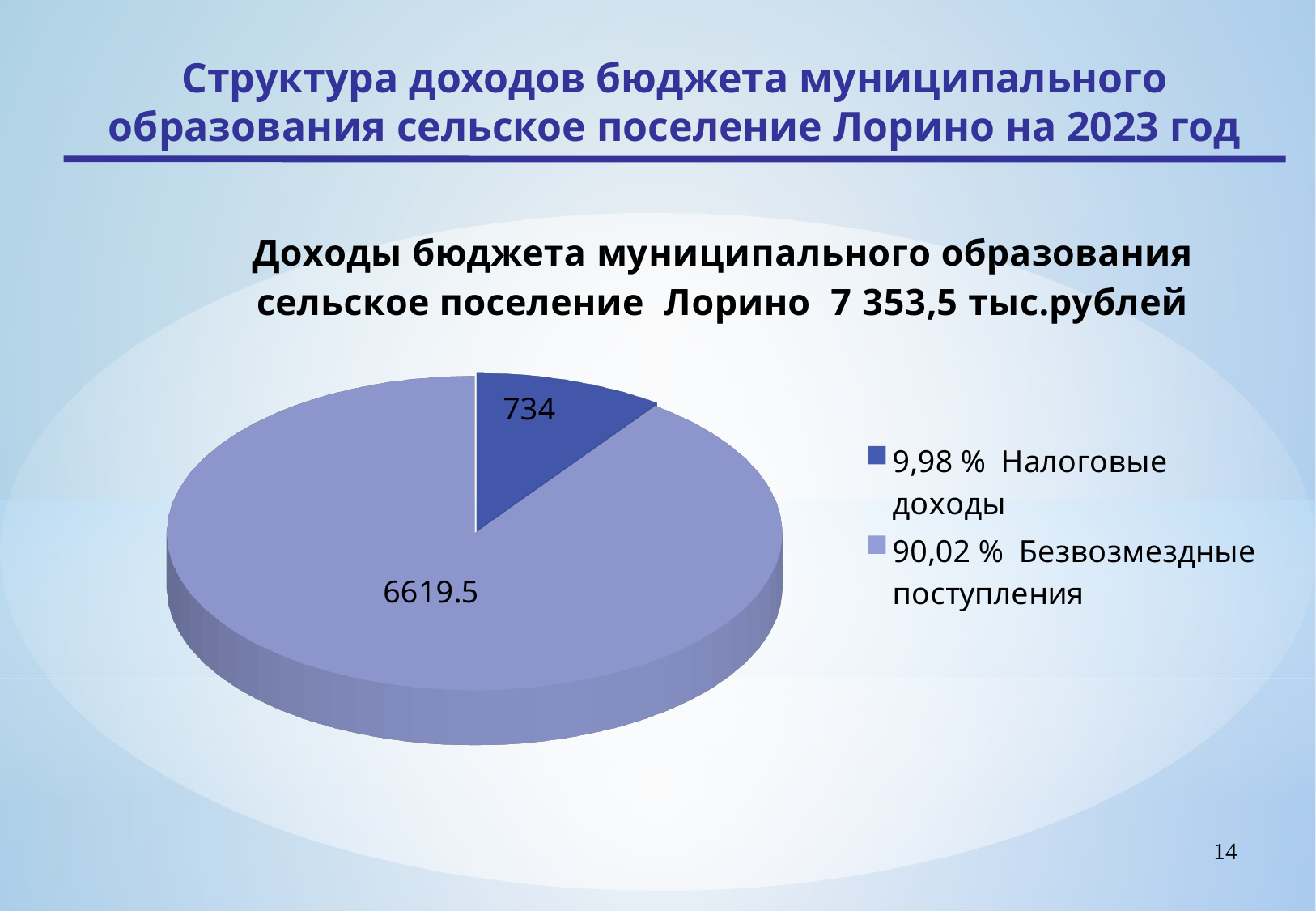
How many entries does the legend list? 2 What total budget income is stated in the chart title? 7 353,5 тыс.рублей What is the value of the Безвозмездные поступления slice? 6619.5 What kind of chart is shown on the slide? pie chart What is the value of the Налоговые доходы slice? 734 Which is larger: Налоговые доходы or Безвозмездные поступления? Безвозмездные поступления What is the difference between the Безвозмездные поступления value and the Налоговые доходы value? 5885.5 What share of the pie does Безвозмездные поступления represent, according to the legend? 90,02 % How many slices does the pie chart have? 2 Which category has the smallest slice of the pie? Налоговые доходы Which category has the largest slice of the pie? Безвозмездные поступления What share of the pie does Налоговые доходы represent, according to the legend? 9,98 %